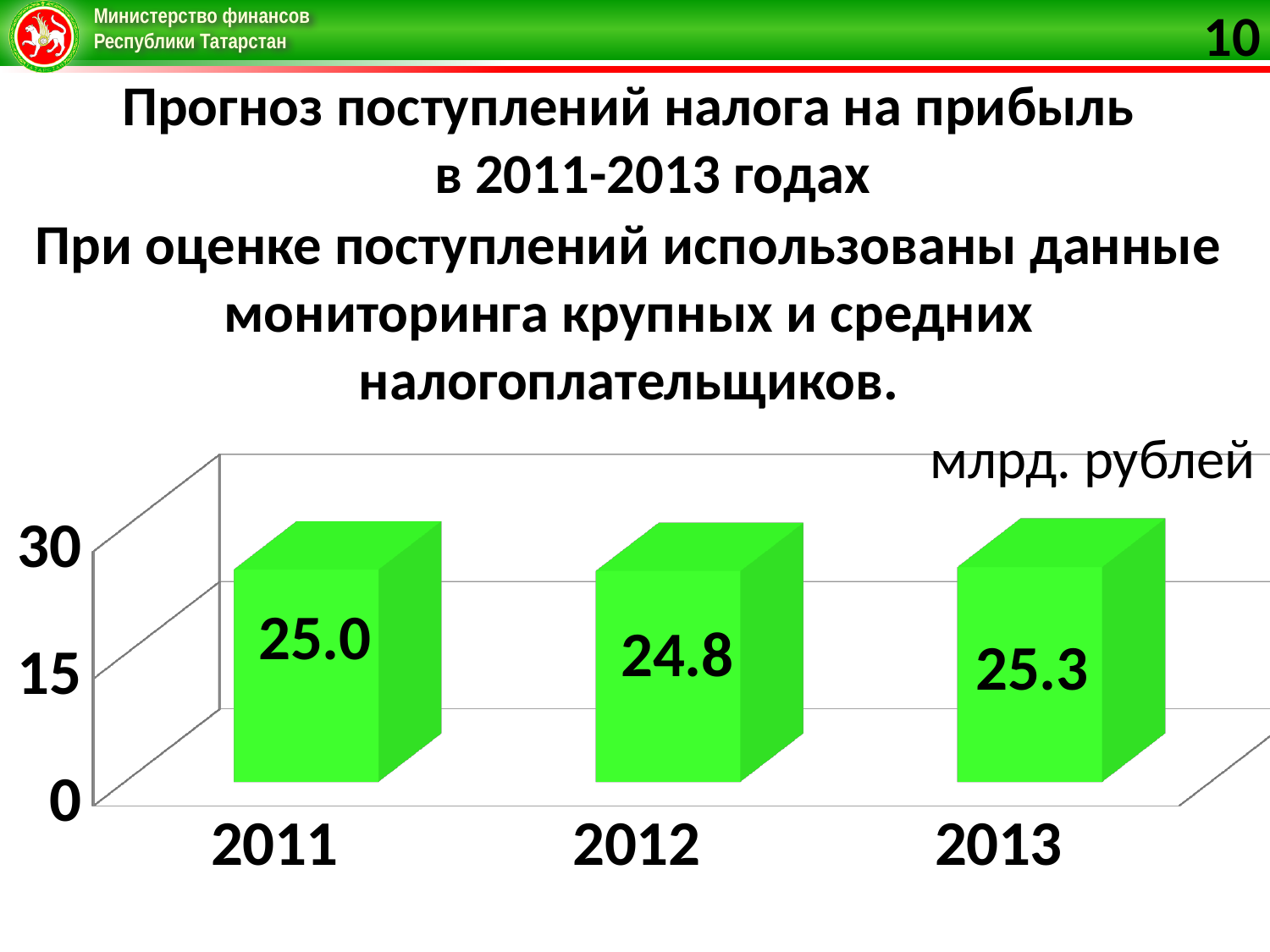
What is the forecast profit tax revenue for 2012? 24.8 What is the difference between the values for 2013 and 2012? 0.5 Which year has the lowest forecast profit tax revenue? 2012 What is the forecast profit tax revenue for 2011? 25.0 Which is larger, the value for 2011 or the value for 2013? 2013 What is the forecast profit tax revenue for 2013? 25.3 What is the difference between the values for 2011 and 2012? 0.2 Which year has the highest forecast profit tax revenue? 2013 How many years are shown on the chart? 3 In what units are the chart values given? млрд. рублей Is the value for 2012 greater or less than 15? greater What kind of chart is shown on the slide? bar chart